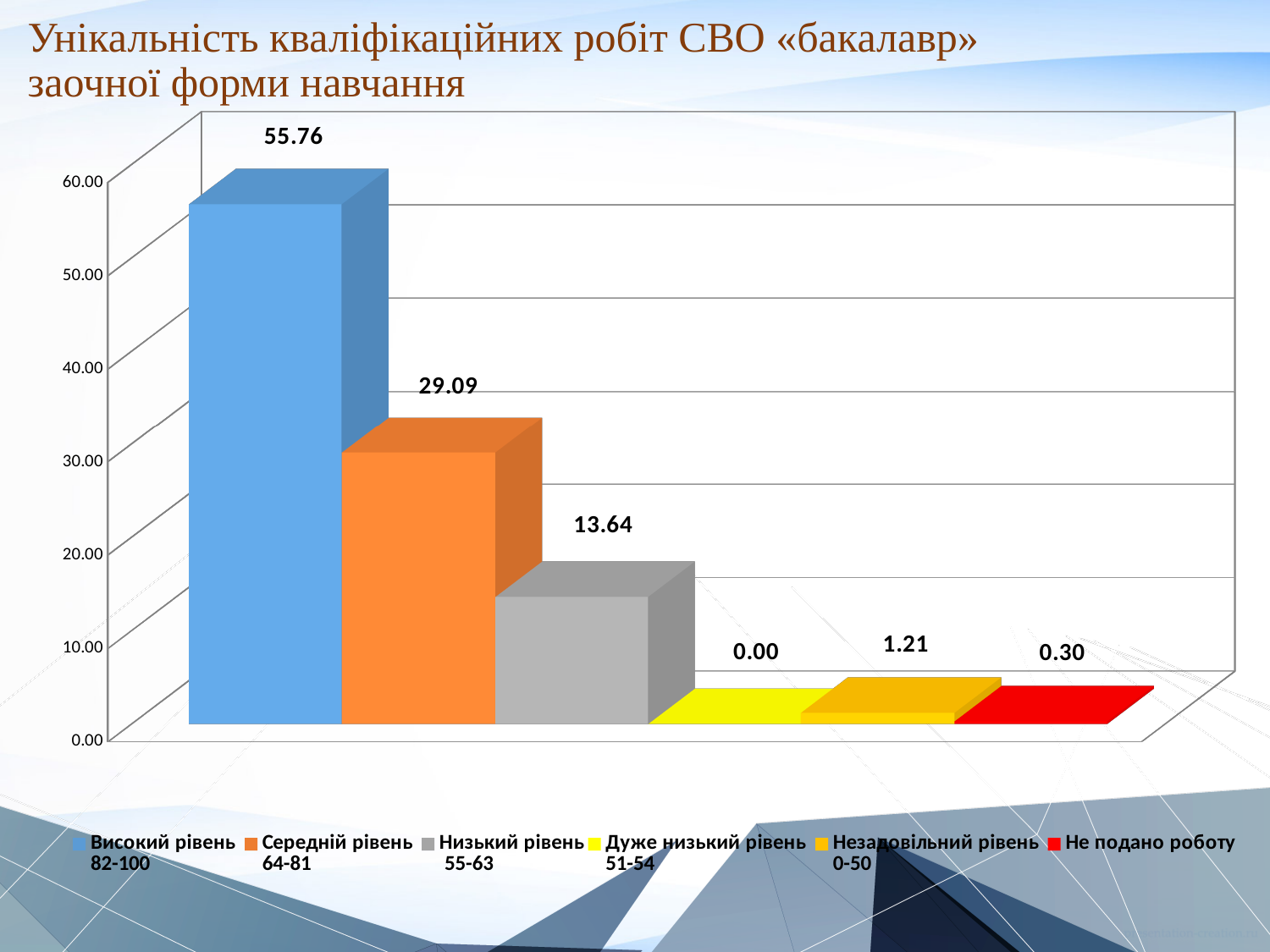
Which category has the lowest value? Дуже низький рівень 51-54 Which category has the highest value? Високий рівень 82-100 What is the difference between the values for Високий рівень and Середній рівень? 26.67 What is the value for Не подано роботу? 0.30 What is the value for Високий рівень (82-100)? 55.76 Which is larger: the value for Незадовільний рівень or the value for Не подано роботу? Незадовільний рівень What is the value for Незадовільний рівень (0-50)? 1.21 What is the value for Середній рівень (64-81)? 29.09 How many entries does the legend list? 6 How many bars are shown in the chart? 6 What kind of chart is shown on the slide? Bar chart What is the value for Низький рівень (55-63)? 13.64